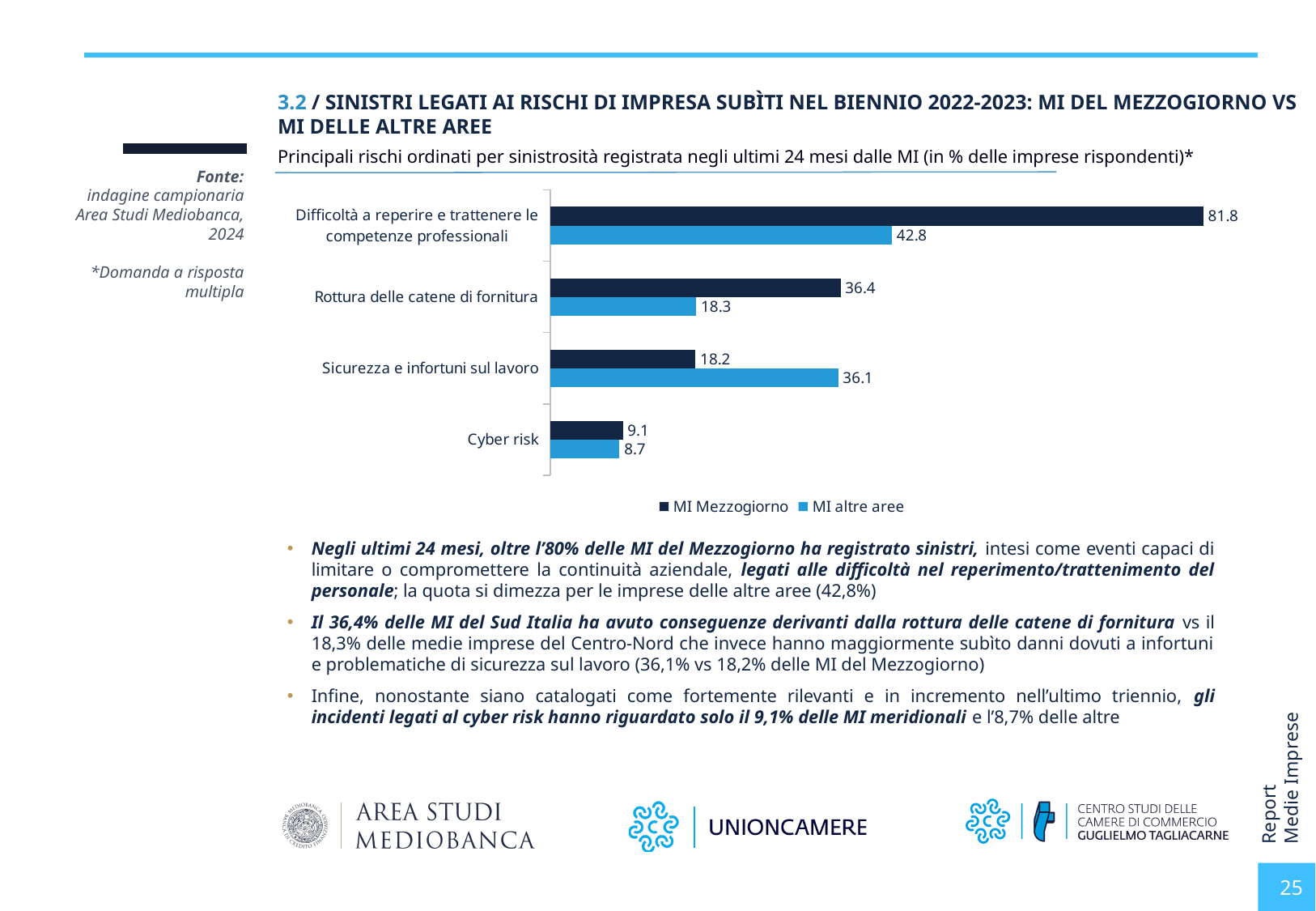
What is the value for MI altre aree for 'Sicurezza e infortuni sul lavoro'? 36.1 Which category has the lowest value for MI altre aree? Cyber risk Which category has the highest value for MI Mezzogiorno? Difficoltà a reperire e trattenere le competenze professionali For 'Rottura delle catene di fornitura', which series has the larger value, MI Mezzogiorno or MI altre aree? MI Mezzogiorno What is the value for MI altre aree for 'Rottura delle catene di fornitura'? 18.3 What is the value for MI Mezzogiorno for 'Cyber risk'? 9.1 How many risk categories are shown in the chart? 4 What is the value for MI Mezzogiorno for 'Difficoltà a reperire e trattenere le competenze professionali'? 81.8 How many series does the legend list? 2 What kind of chart is shown on the slide? Bar chart What is the difference between MI Mezzogiorno and MI altre aree for 'Difficoltà a reperire e trattenere le competenze professionali'? 39.0 What is the difference between MI altre aree and MI Mezzogiorno for 'Sicurezza e infortuni sul lavoro'? 17.9